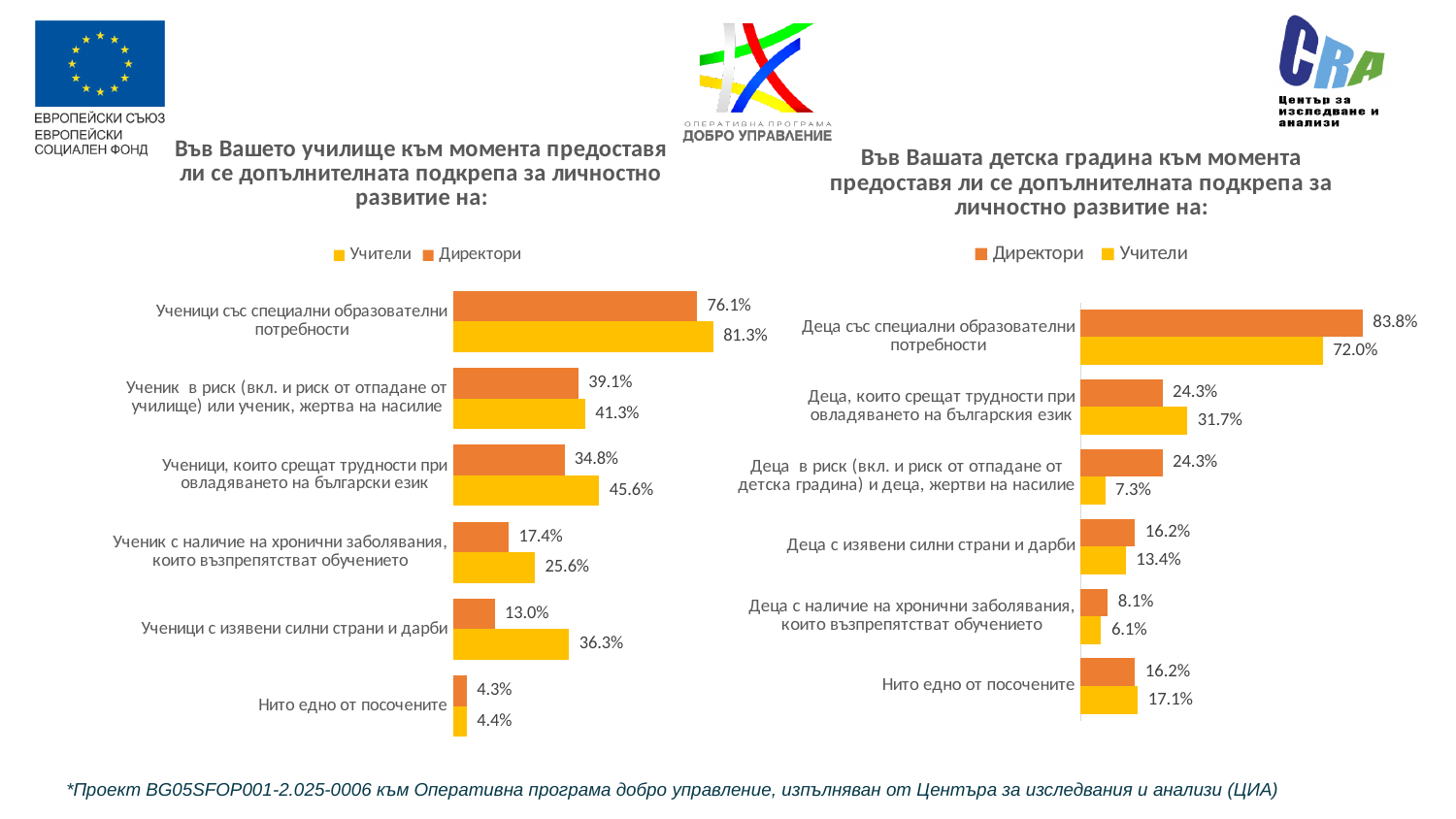
In the left chart (school), what is the value for Учители for 'Ученици с изявени силни страни и дарби'? 36.3% How many categories are shown in the left chart (school)? 6 In the right chart (kindergarten), which is larger for 'Деца, които срещат трудности при овладяването на българския език': Директори or Учители? Учители How many series does the legend of the right chart (kindergarten) list? 2 In the right chart (kindergarten), what is the value for Директори for 'Деца със специални образователни потребности'? 83.8% In the right chart (kindergarten), which category has the highest value for Директори? Деца със специални образователни потребности In the left chart (school), what is the value for Директори for 'Ученици със специални образователни потребности'? 76.1% In the right chart (kindergarten), what is the value for Учители for 'Нито едно от посочените'? 17.1% In the left chart (school), which category has the lowest value for Учители? Нито едно от посочените In the left chart (school), what is the difference between the Учители and Директори values for 'Ученици с изявени силни страни и дарби'? 23.3% In the right chart (kindergarten), what is the difference between the Директори and Учители values for 'Деца в риск (вкл. и риск от отпадане от детска градина) и деца, жертви на насилие'? 17.0% What type of chart is the left chart (school)? Bar chart